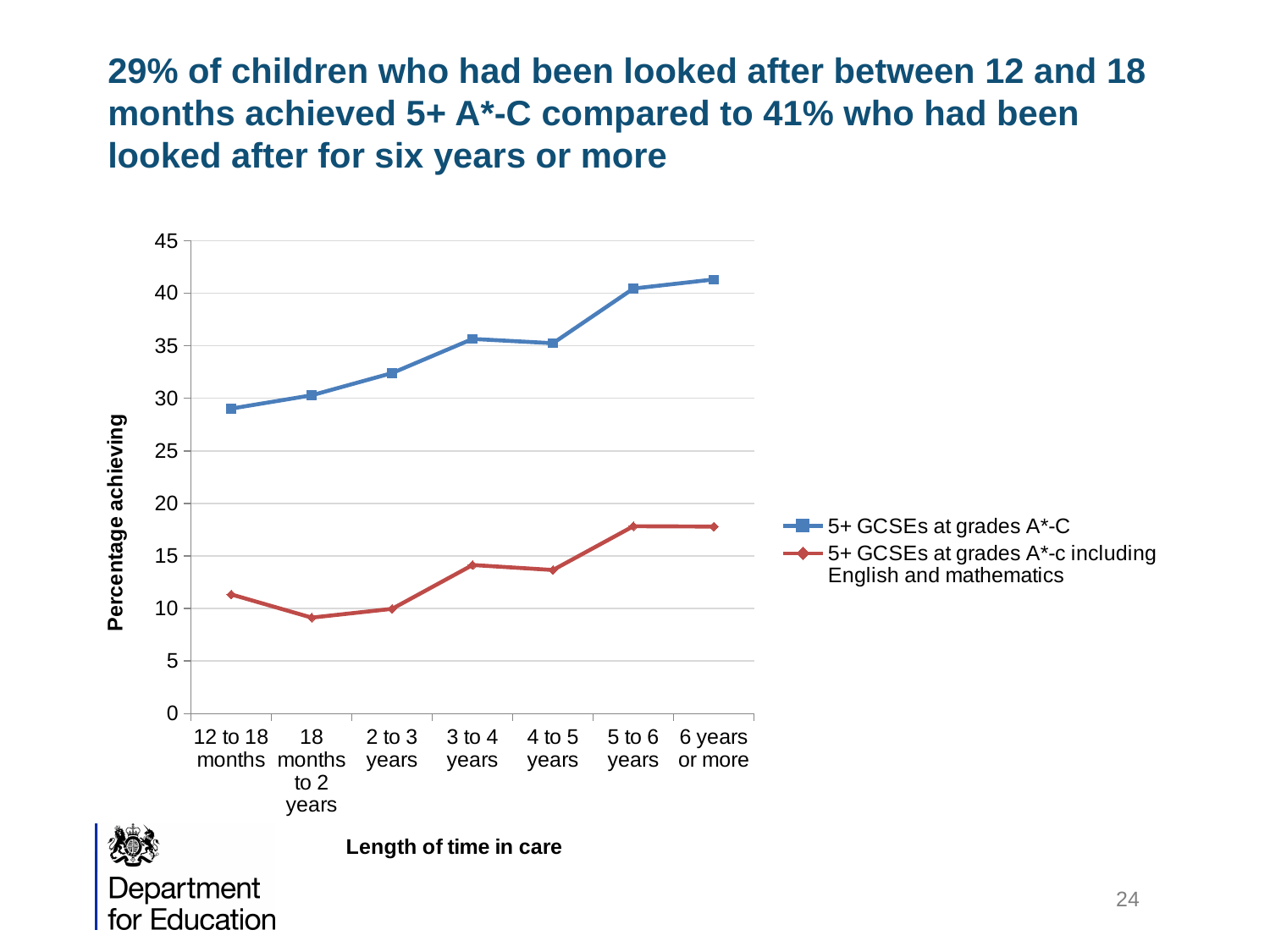
Which category has the lowest value for the 5+ GCSEs at grades A*-c including English and mathematics series? 18 months to 2 years For 3 to 4 years, which series has the larger value: 5+ GCSEs at grades A*-C or 5+ GCSEs at grades A*-c including English and mathematics? 5+ GCSEs at grades A*-C Is the value for 5 to 6 years in the 5+ GCSEs at grades A*-c including English and mathematics series greater or less than 15? greater What kind of chart is shown on the slide? Line chart Is the value for 6 years or more in the 5+ GCSEs at grades A*-C series greater or less than 40? greater Does the 5+ GCSEs at grades A*-C series generally rise or fall as length of time in care increases? Rise Which category has the lowest value for the 5+ GCSEs at grades A*-C series? 12 to 18 months Is the value for 2 to 3 years in the 5+ GCSEs at grades A*-C series greater or less than 30? greater How many series does the legend list? 2 What is the title of the vertical axis? Percentage achieving How many length-of-time-in-care categories are shown on the x axis? 7